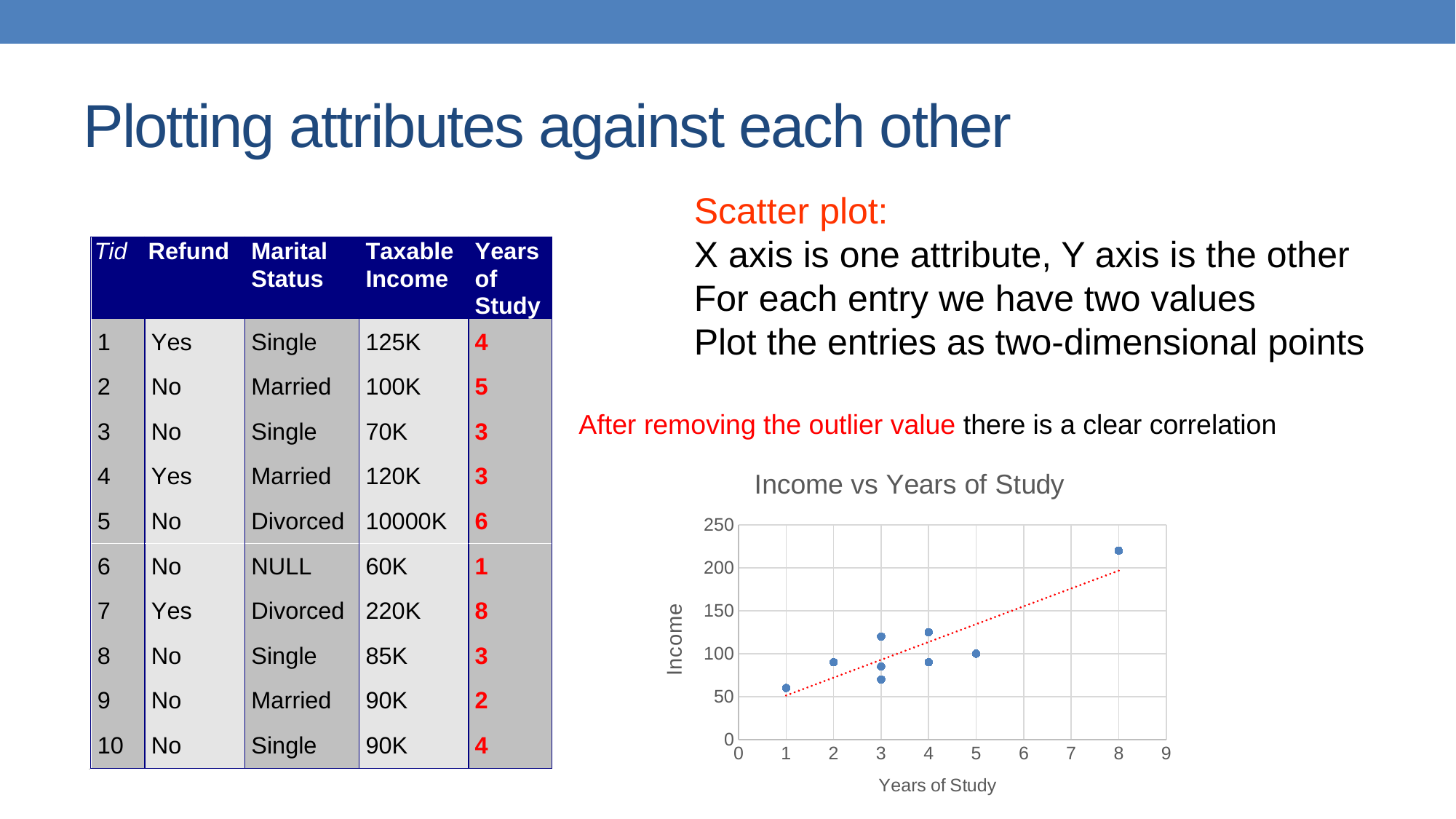
Is the income value for the point at 2 years of study greater or less than 50? greater What is the label of the y axis of the chart? Income How many data points are plotted in the chart? 9 At how many years of study is the point with the lowest income? 1 What kind of chart is shown on the slide? scatter plot What is the title of the chart? Income vs Years of Study How many data points are plotted at 3 years of study? 3 Is the income value for the point at 1 year of study greater or less than 100? less Is the income value for the point at 8 years of study greater or less than 200? greater Does income generally rise or fall as years of study increase along the x axis? rise What is the income value of the point at 5 years of study? 100 At how many years of study is the point with the highest income? 8